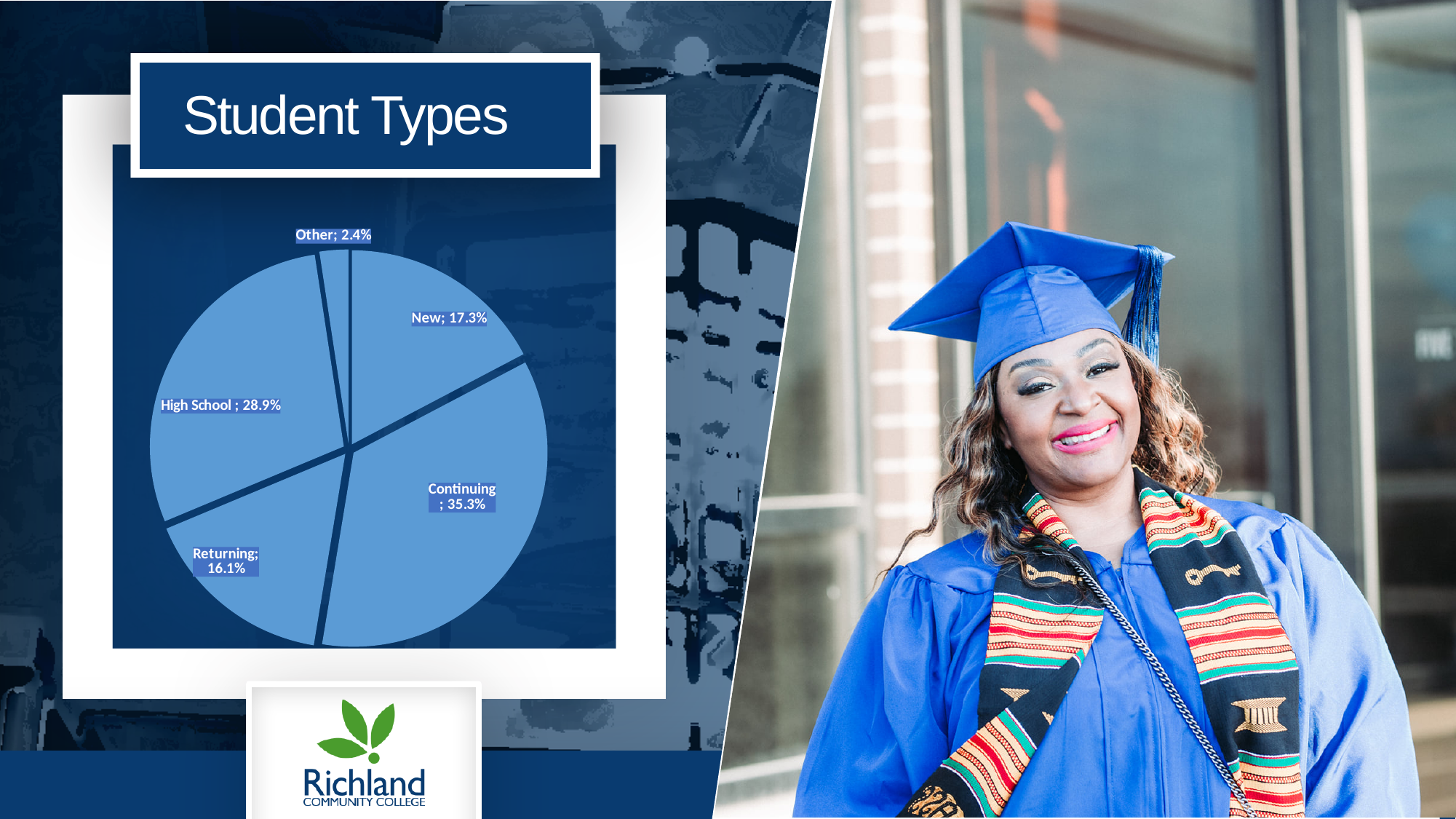
How many student types are shown in the pie chart? 5 What is the difference in percentage points between Continuing and High School students? 6.4 What is the title of the chart? Student Types Which student type has the largest share of the pie? Continuing Which student type has the smallest share of the pie? Other What type of chart is shown on the slide? pie chart What percentage of students are Continuing? 35.3% Which is larger, the share for High School or the share for New? High School What percentage of students are Other? 2.4% What percentage of students are High School? 28.9% What percentage of students are New? 17.3% What percentage of students are Returning? 16.1%